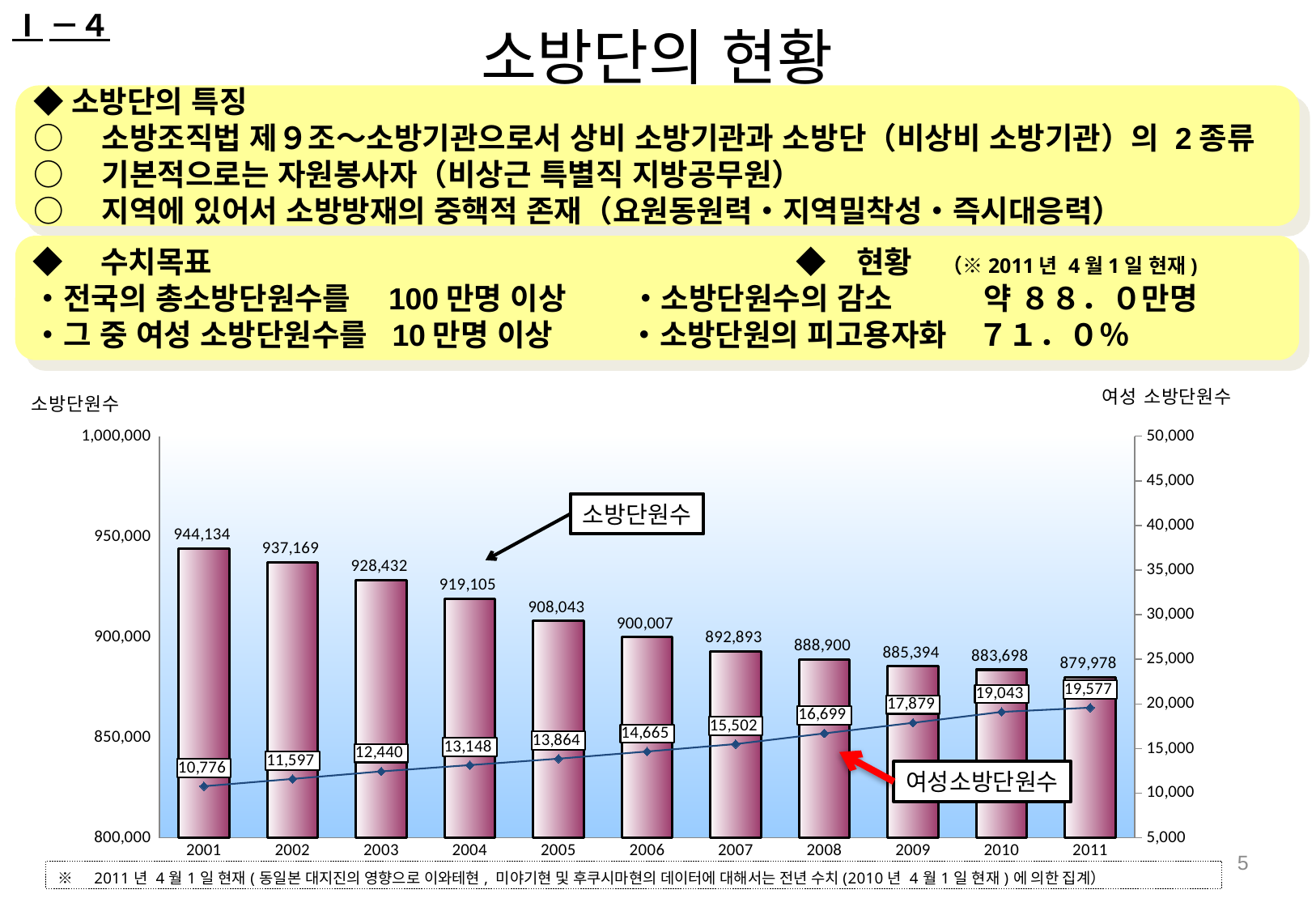
What is the 소방단원수 value for 2001? 944,134 By how much did the 여성 소방단원수 increase from 2001 to 2011? 8,801 Which is larger, the 소방단원수 in 2005 or in 2006? 2005 What is the 여성 소방단원수 value for 2011? 19,577 What is the 여성 소방단원수 value for 2008? 16,699 What is the difference between the 소방단원수 in 2001 and in 2011? 64,156 How many data series are plotted in the chart? 2 What is the 소방단원수 value for 2011? 879,978 Which year has the highest 소방단원수? 2001 Does the 소방단원수 rise or fall from 2001 to 2011? fall How many years are shown on the x axis of the chart? 11 Which year has the lowest 여성 소방단원수? 2001